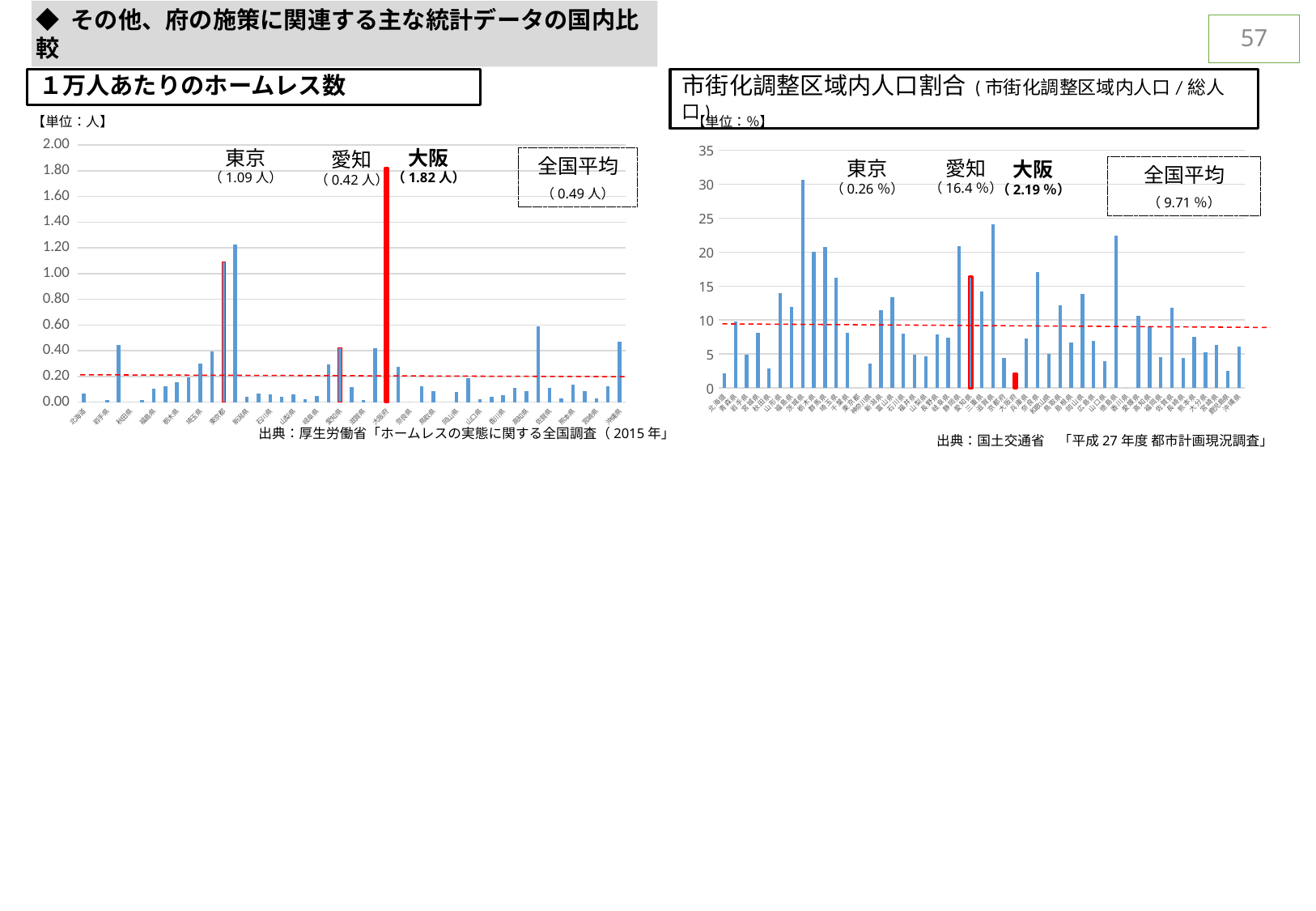
In the right chart (市街化調整区域内人口割合), what is the value for 東京? 0.26% In the left chart (１万人あたりのホームレス数), what is the value for 東京? 1.09人 In the right chart (市街化調整区域内人口割合), what is the value for 愛知? 16.4% In the right chart (市街化調整区域内人口割合), which is larger, the value for 愛知 or the value for 大阪? 愛知 In the left chart (１万人あたりのホームレス数), what is the value for 大阪? 1.82人 In the left chart (１万人あたりのホームレス数), what is the 全国平均 value? 0.49人 In the left chart (１万人あたりのホームレス数), what is the difference between the values for 大阪 and 東京? 0.73人 In the right chart (市街化調整区域内人口割合), what is the difference between the values for 愛知 and 大阪? 14.21% In the right chart (市街化調整区域内人口割合), what is the 全国平均 value? 9.71% What kind of chart is the left chart (１万人あたりのホームレス数)? bar chart In the left chart (１万人あたりのホームレス数), which of the three annotated prefectures (東京, 愛知, 大阪) has the highest value? 大阪 In the left chart (１万人あたりのホームレス数), which is larger, the value for 愛知 or the 全国平均? 全国平均